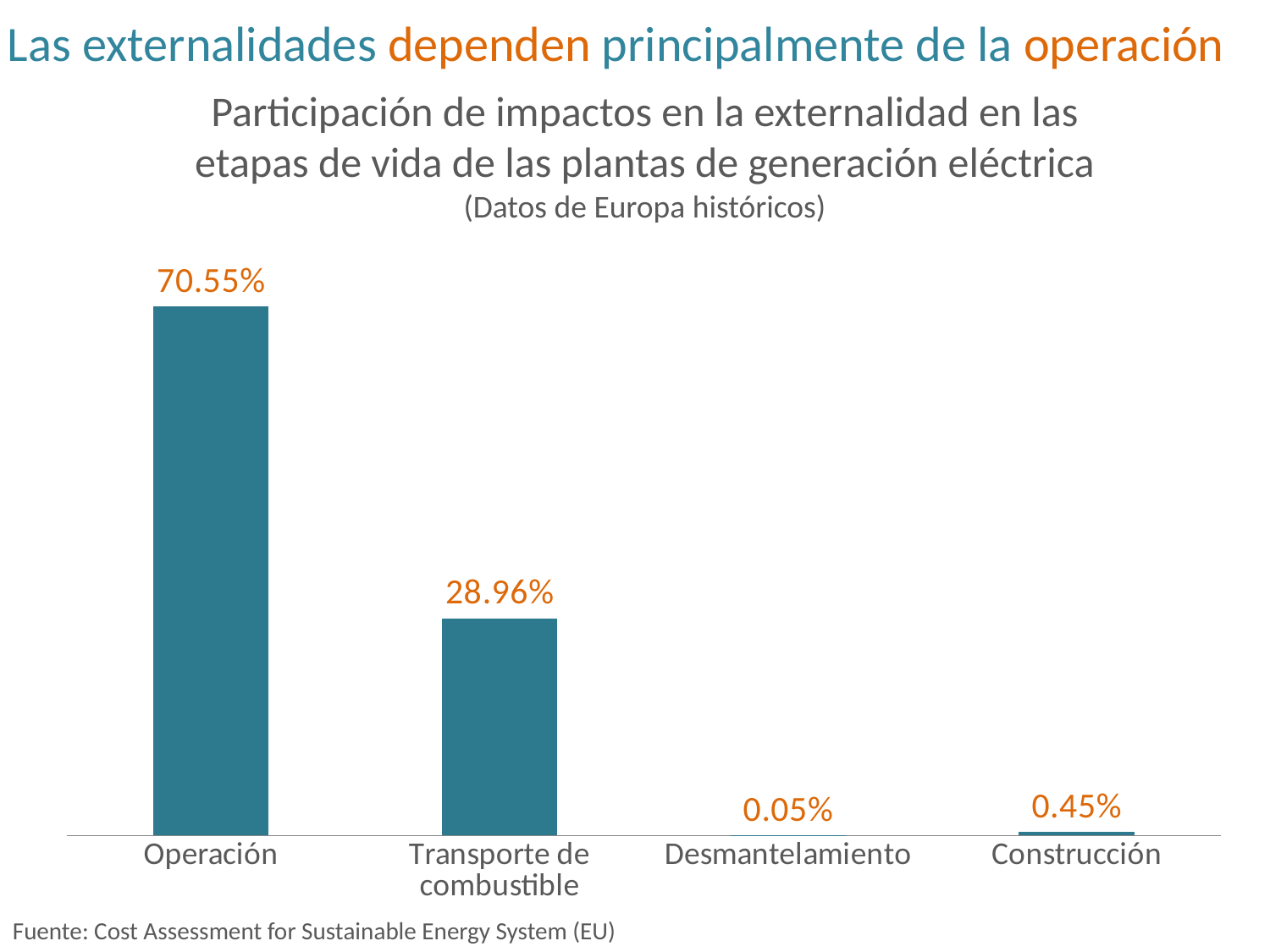
What is the value for Construcción? 0.45% What is the value for Desmantelamiento? 0.05% What kind of chart is shown on the slide? Bar chart What source is cited for the chart data? Cost Assessment for Sustainable Energy System (EU) What is the difference between the values for Construcción and Desmantelamiento? 0.40% Which category has the lowest value? Desmantelamiento How many categories are shown in the chart? 4 Which is larger, the value for Construcción or the value for Desmantelamiento? Construcción What is the difference between the values for Operación and Transporte de combustible? 41.59% What is the value for Operación? 70.55% Which category has the highest value? Operación What is the value for Transporte de combustible? 28.96%